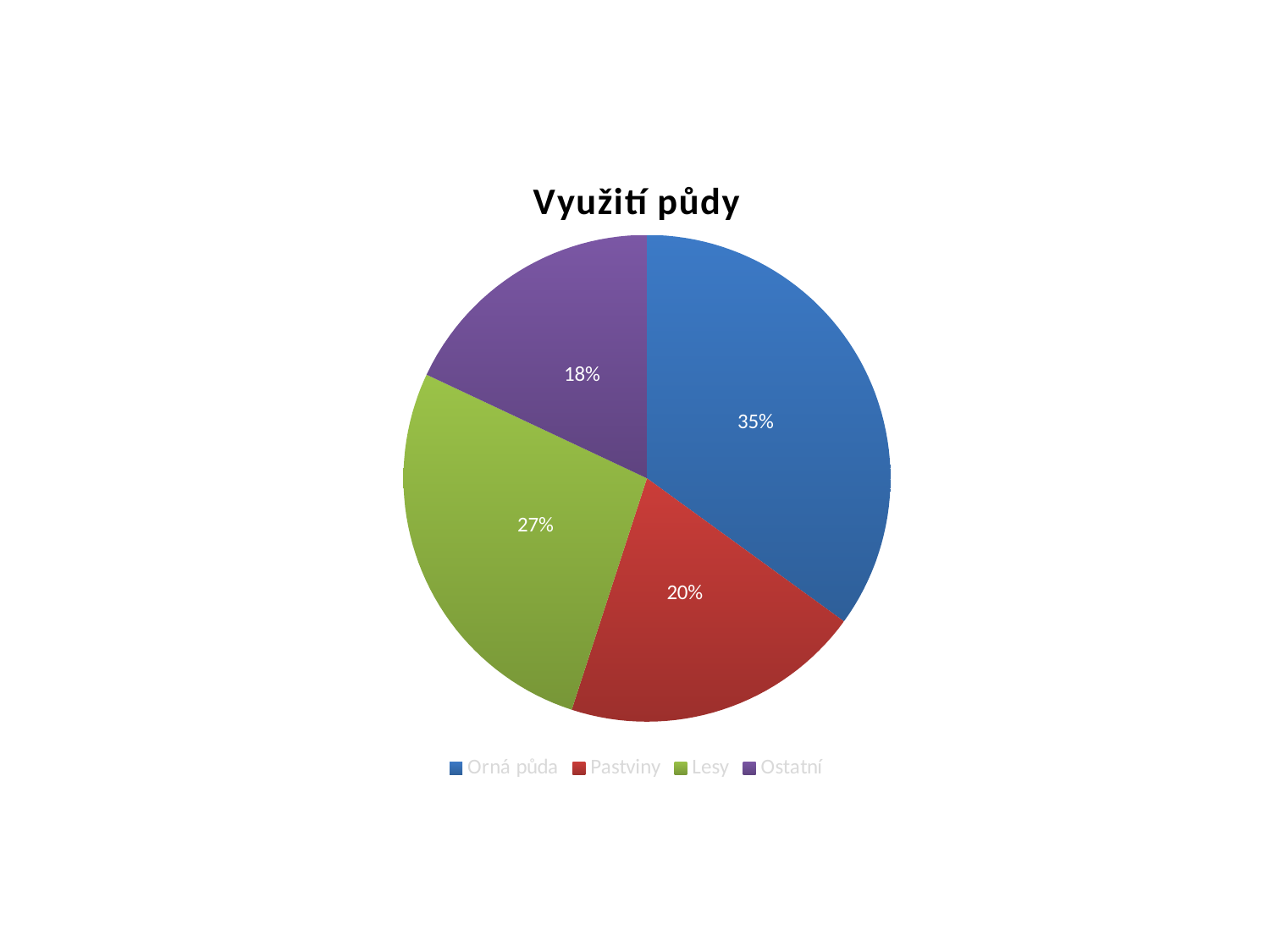
What share of the pie does Ostatní have? 18% What colour is the slice for Lesy? green Which is larger, the share of Pastviny or the share of Lesy? Lesy What share of the pie does Orná půda have? 35% What share of the pie does Lesy have? 27% Which category has the smallest slice? Ostatní Which category has the largest slice? Orná půda What is the difference between the shares of Orná půda and Lesy? 8% What is the title of the chart? Využití půdy What kind of chart is shown on the slide? pie chart How many categories does the pie chart have? 4